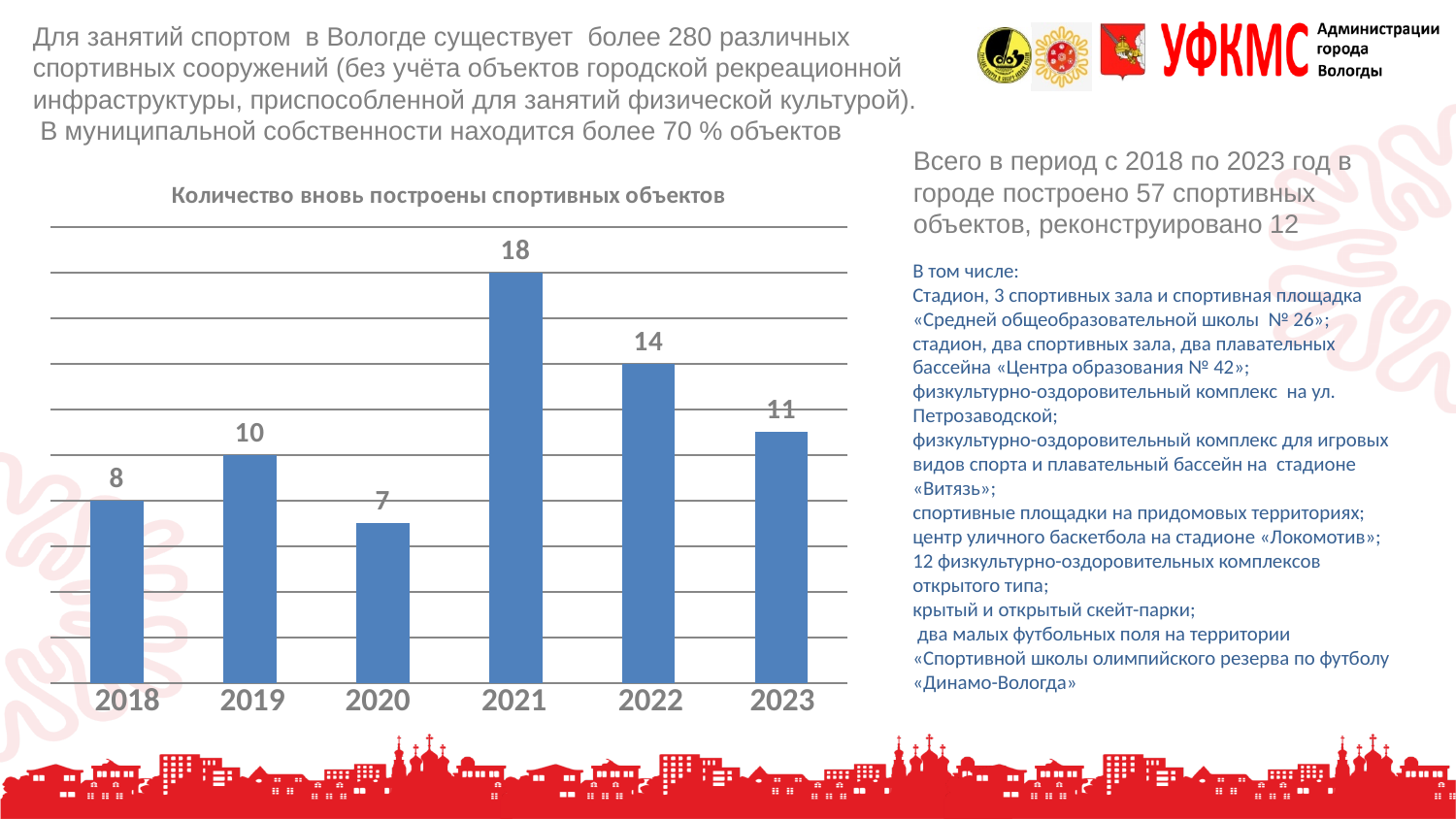
What kind of chart is shown on the slide? bar chart What is the value for 2023 in the chart? 11 What is the difference between the values for 2019 and 2020? 3 What is the difference between the values for 2021 and 2022? 4 What is the title of the chart? Количество вновь построены спортивных объектов Which is larger, the value for 2022 or the value for 2023? 2022 How many years are shown on the x axis of the chart? 6 Do the values rise or fall from 2019 to 2020? fall Which year has the lowest value in the chart? 2020 What is the value for 2018 in the chart? 8 What is the value for 2021 in the chart 'Количество вновь построены спортивных объектов'? 18 Which year has the highest value in the chart? 2021